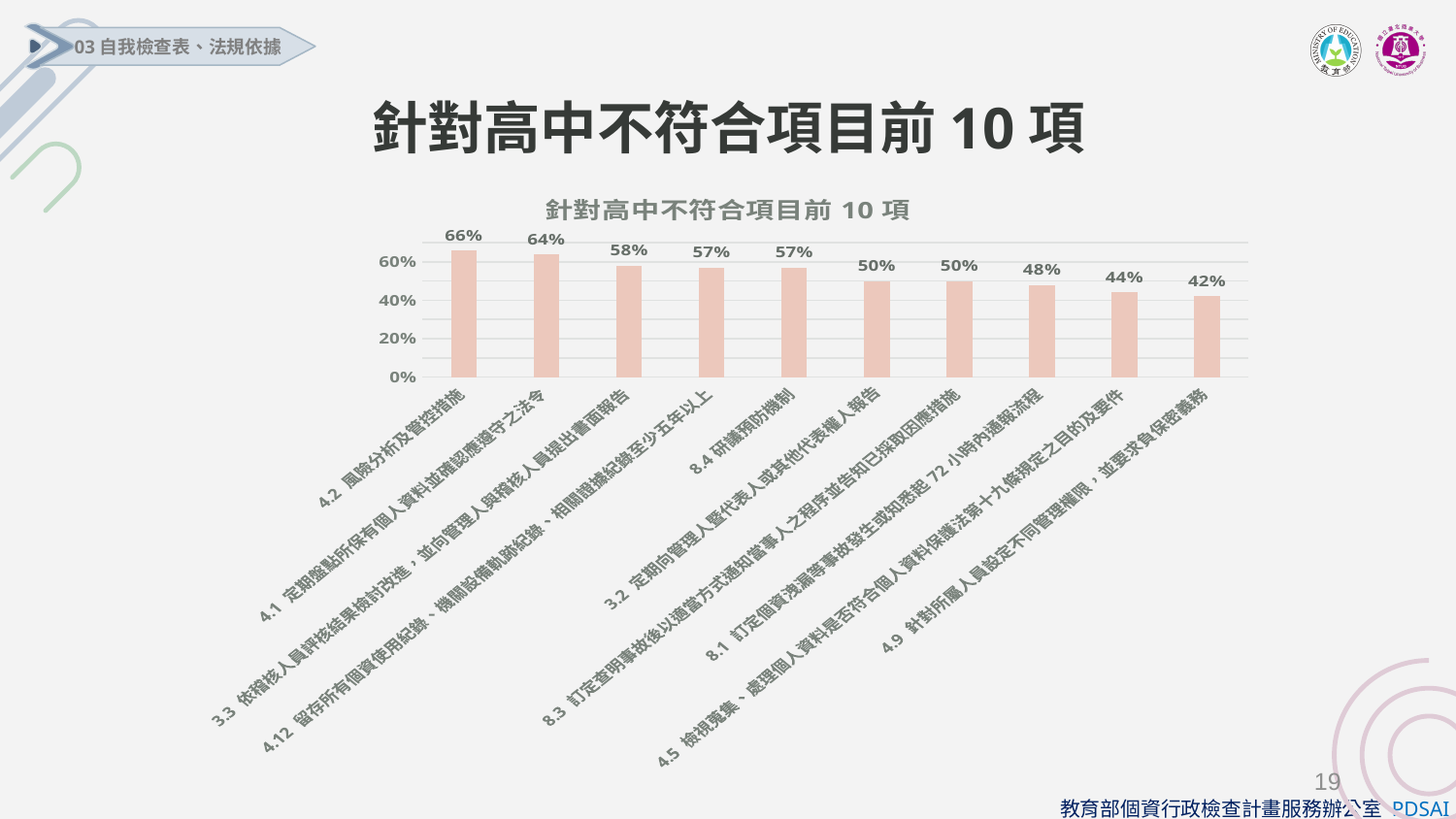
What is the difference between the values for 4.2 風險分析及管控措施 and 4.1 定期盤點所保有個人資料並確認應遵守之法令? 2% What is the value for 8.1 訂定個資洩漏等事故發生或知悉起72小時內通報流程? 48% How many categories (bars) are plotted in the chart? 10 What is the value for 4.9 針對所屬人員設定不同管理權限，並要求負保密義務? 42% What is the value for 4.2 風險分析及管控措施? 66% What is the title of the chart? 針對高中不符合項目前 10 項 Do the values generally rise or fall from left to right across the chart? fall Which category has the lowest value? 4.9 針對所屬人員設定不同管理權限，並要求負保密義務 Which category has the highest value? 4.2 風險分析及管控措施 What type of chart is shown on the slide? bar chart Which is larger, the value for 3.3 依稽核人員評核結果檢討改進 or the value for 4.5 檢視蒐集、處理個人資料是否符合個人資料保護法第十九條規定之目的及要件? 3.3 依稽核人員評核結果檢討改進 What is the value for 8.4 研議預防機制? 57%